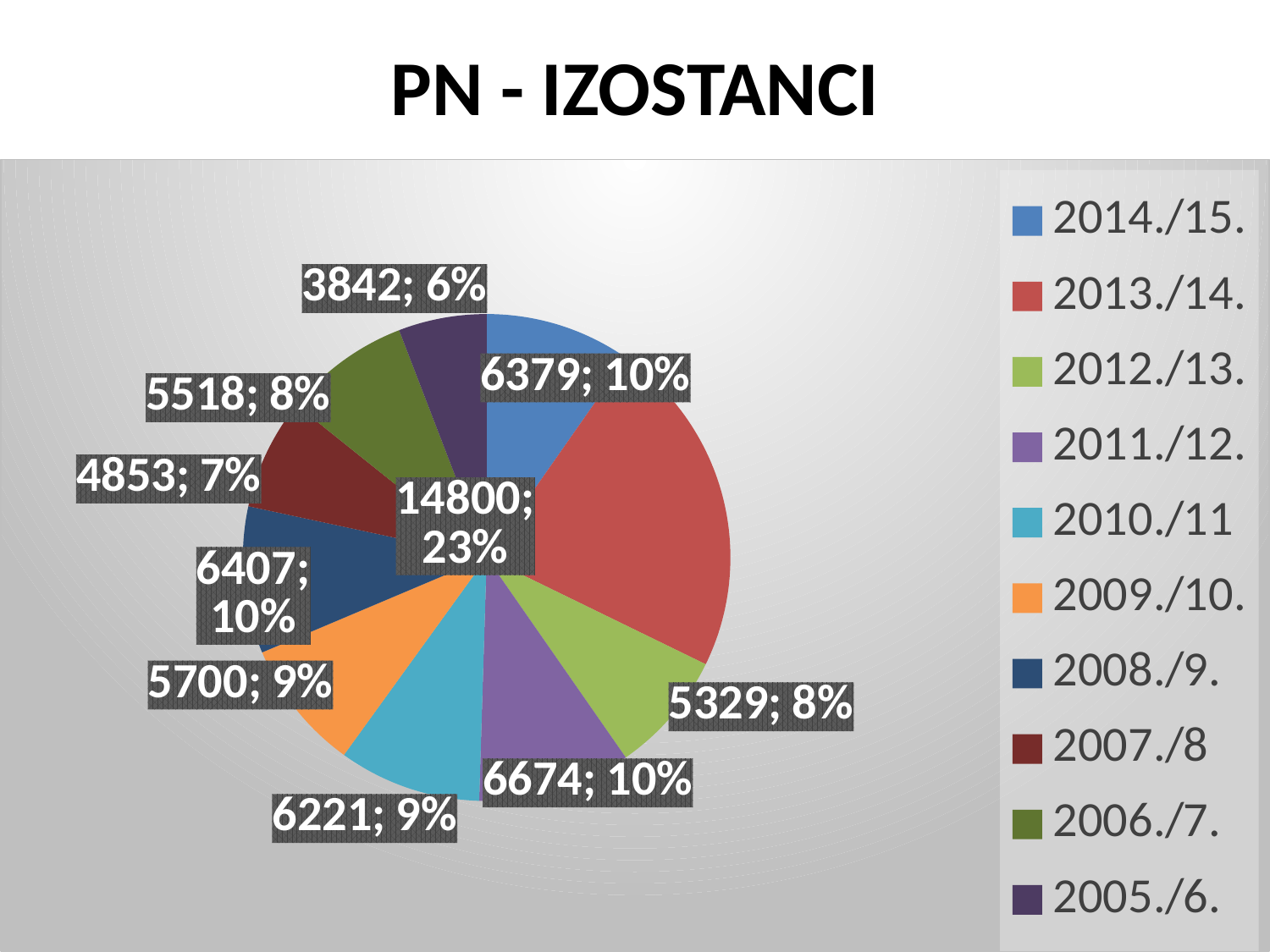
Which is larger, the value for 2011./12. or the value for 2012./13.? 2011./12. What share of the pie does 2013./14. represent? 23% Which school year has the largest slice? 2013./14. What is the value for 2005./6.? 3842 What is the difference between the values for 2013./14. and 2014./15.? 8421 How many slices does the pie chart have? 10 Which school year has the smallest slice? 2005./6. What is the value for 2009./10.? 5700 What is the title of the chart? PN - IZOSTANCI What kind of chart is shown on the slide? pie chart What is the value for 2013./14.? 14800 What is the value for 2014./15.? 6379